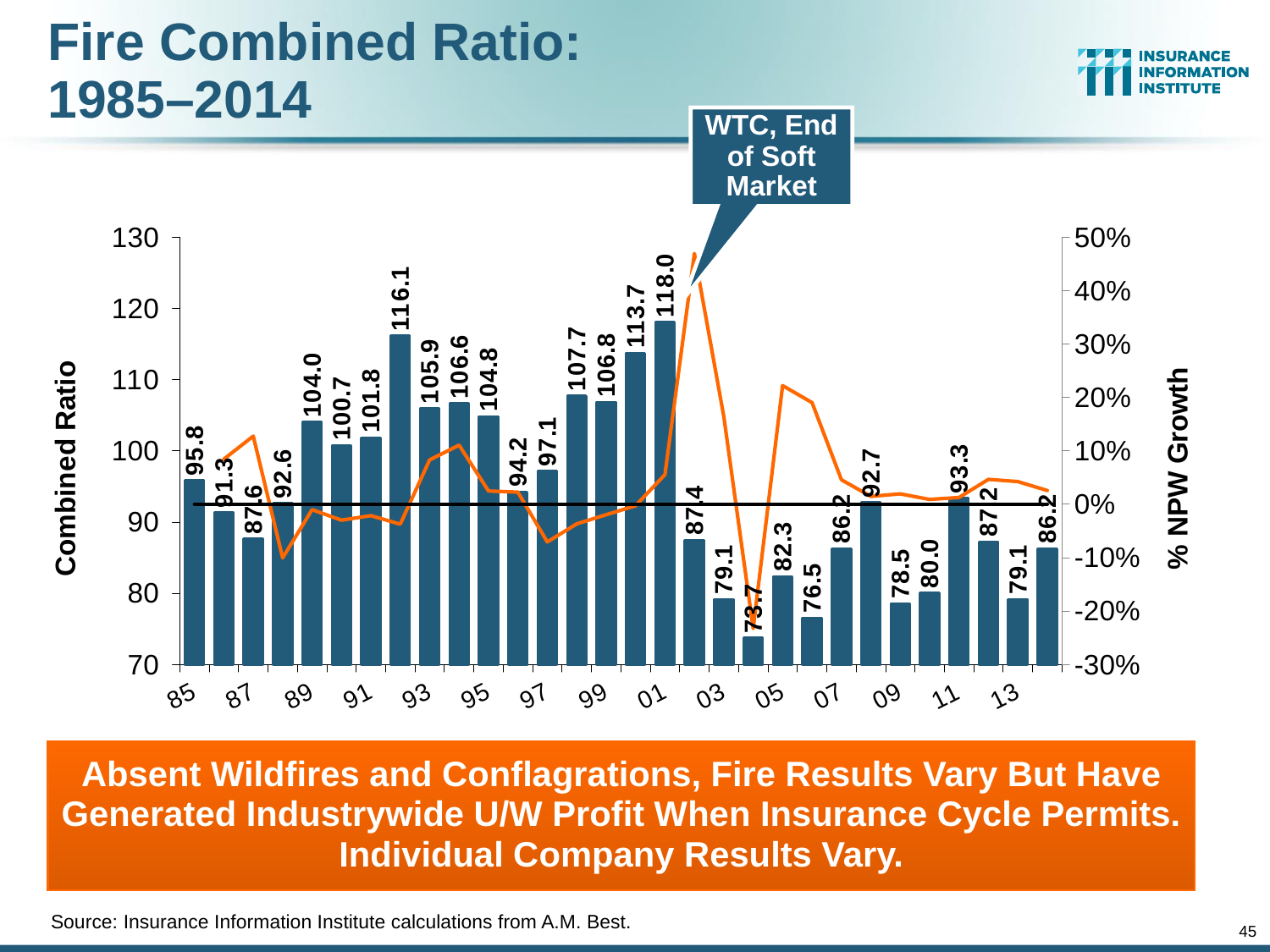
What was the fire combined ratio in 2013? 79.1 What was the fire combined ratio in 1997? 97.1 Is the combined ratio for 1992 greater or less than 110? greater How many years (bars) are plotted on the chart? 30 What kind of chart is used to show the combined ratio values? Bar chart (with a line for % NPW growth) What was the fire combined ratio in 1985? 95.8 Which year had a higher combined ratio, 1993 or 1999? 1999 What is the lowest combined ratio value shown on the chart? 73.7 What is the title of the right-hand vertical axis? % NPW Growth Which year had the highest combined ratio? 2001 What was the fire combined ratio in 2001? 118.0 How much higher was the combined ratio in 2001 than in 1985? 22.2